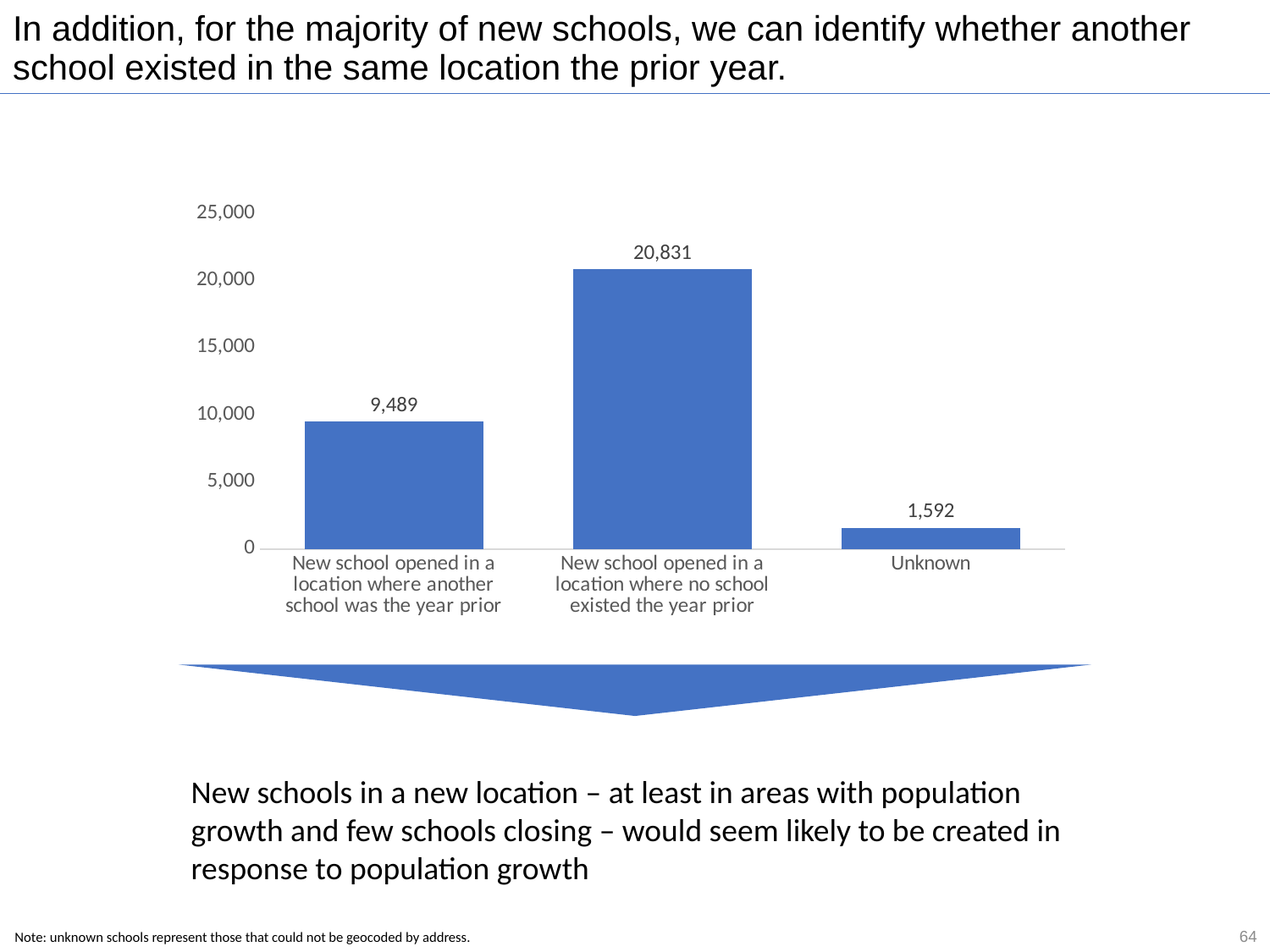
How many categories are shown in the chart? 3 Is the value for 'New school opened in a location where no school existed the year prior' greater or less than 20,000? greater What is the difference between the value for 'New school opened in a location where another school was the year prior' and the value for 'Unknown'? 7,897 What kind of chart is shown on the slide? Bar chart Is the value for 'New school opened in a location where another school was the year prior' greater or less than 10,000? less What is the value for 'New school opened in a location where no school existed the year prior'? 20,831 What is the value for 'Unknown'? 1,592 Which is larger: the value for 'New school opened in a location where another school was the year prior' or the value for 'Unknown'? New school opened in a location where another school was the year prior Which category has the highest value? New school opened in a location where no school existed the year prior Which category has the lowest value? Unknown What is the difference between the value for 'New school opened in a location where no school existed the year prior' and the value for 'New school opened in a location where another school was the year prior'? 11,342 What is the value for 'New school opened in a location where another school was the year prior'? 9,489